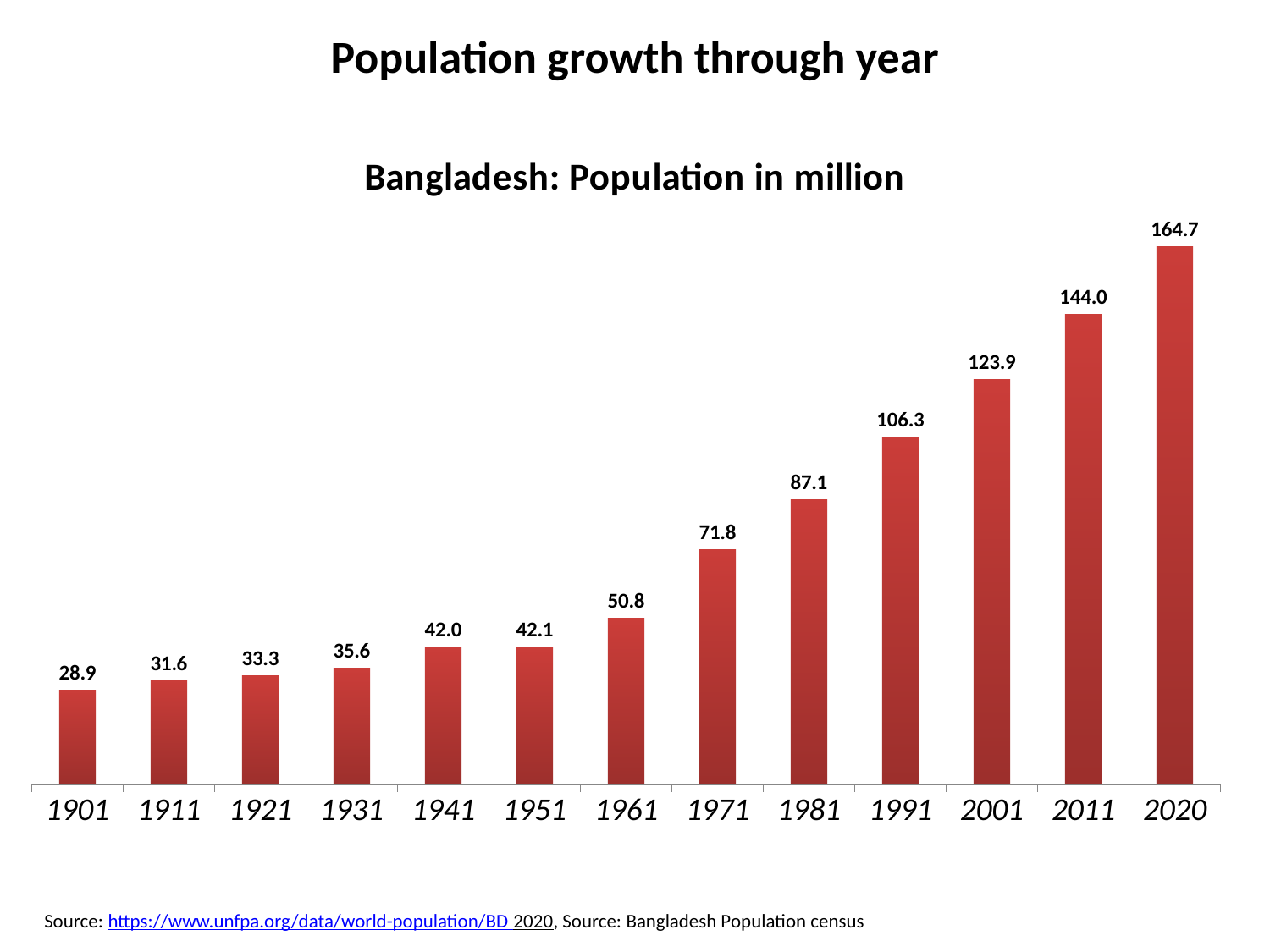
What is the population value shown for 2011? 144.0 Which year has the highest population value? 2020 What is the difference between the population values for 2020 and 2011? 20.7 How many years are shown on the x axis? 13 What is the population value shown for 1901? 28.9 Do the population values rise or fall from 1901 to 2020? Rise What is the title of the chart? Bangladesh: Population in million What is the difference between the population values for 1981 and 1971? 15.3 Which year has the lowest population value? 1901 Which is larger, the population value for 1991 or for 1981? 1991 What kind of chart is shown on the slide? Bar chart What is the population value shown for 1971? 71.8